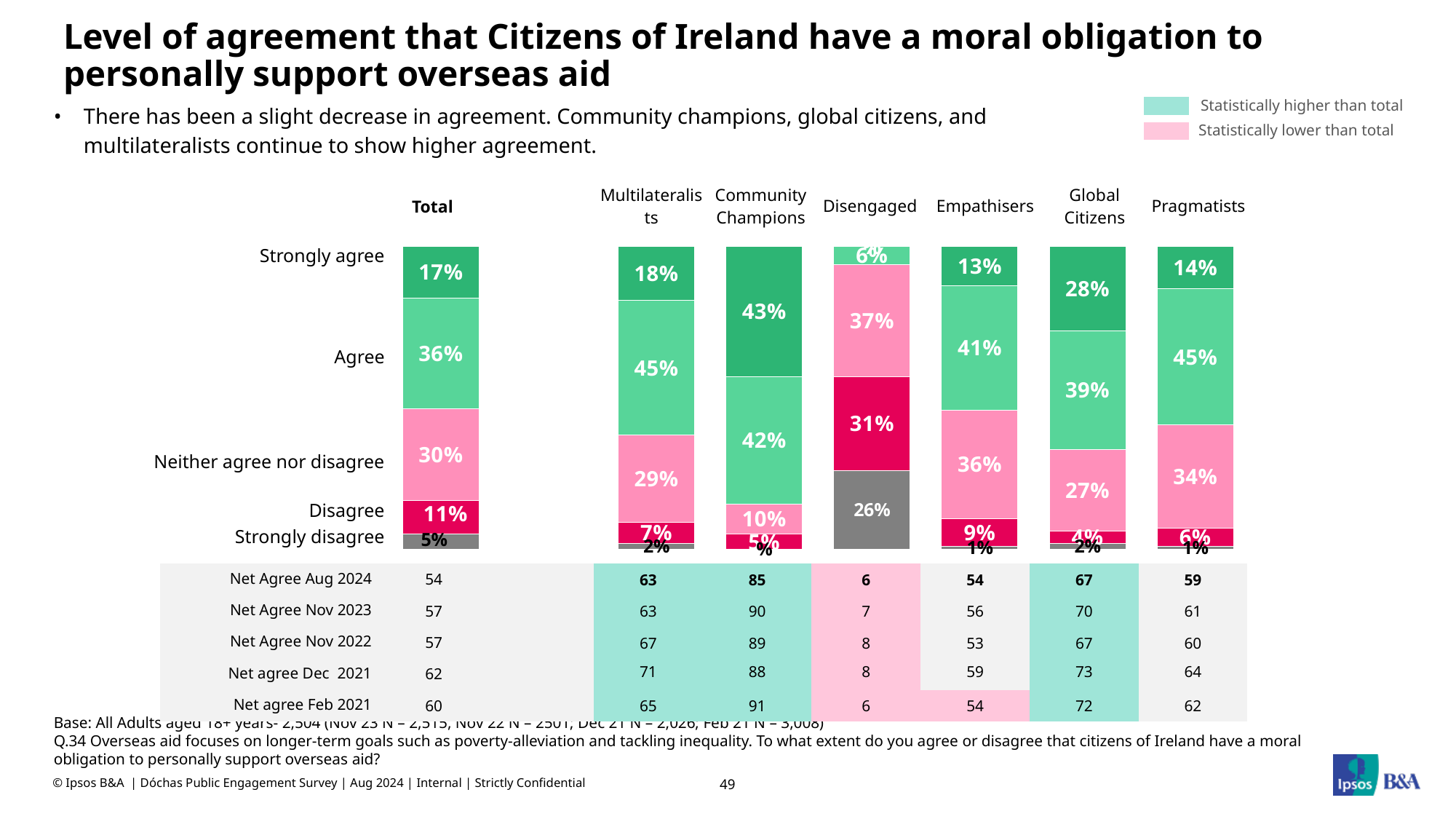
Which group has the lowest Agree value? Disengaged What is the Agree value for the Total group? 36% What kind of chart is shown on the slide? Stacked bar chart What is the Disagree value for Disengaged? 31% What is the Strongly agree value for Community Champions? 43% Which group has the highest Strongly agree value? Community Champions Which is larger, the Agree value for Multilateralists or for Global Citizens? Multilateralists What is the Strongly disagree value for Disengaged? 26% How many groups (bars) are shown in the chart? 7 What is the difference between the Strongly agree values for Global Citizens and Total? 11% What is the Net Agree Aug 2024 value for Community Champions in the table below the chart? 85 What is the Neither agree nor disagree value for Empathisers? 36%